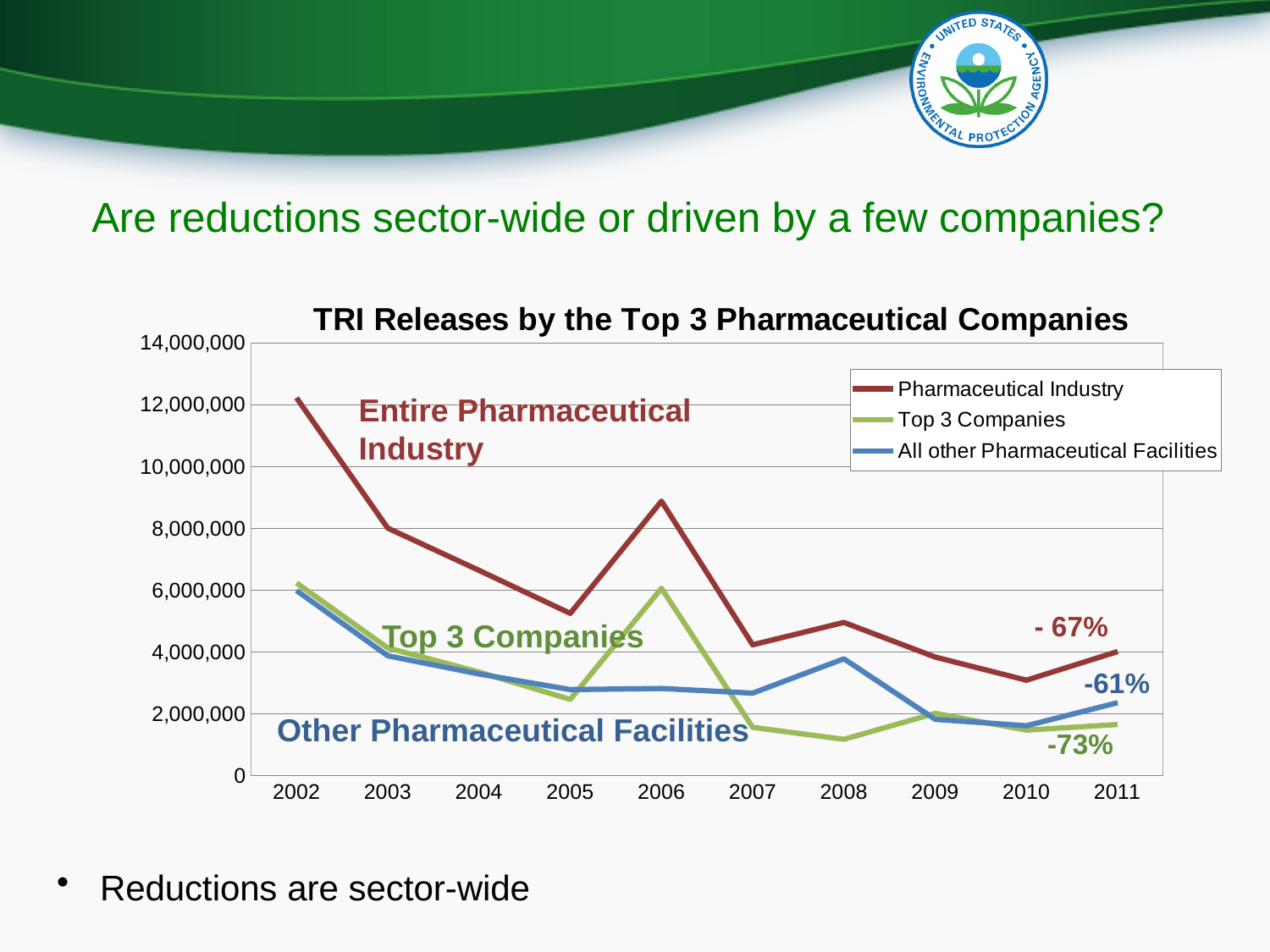
Is the Pharmaceutical Industry value for 2006 greater or less than 8,000,000? greater In 2006, which is larger: the Top 3 Companies value or the All other Pharmaceutical Facilities value? Top 3 Companies Is the Top 3 Companies value for 2008 greater or less than 2,000,000? less What percentage change is labelled for the Pharmaceutical Industry line at the right of the chart? - 67% What type of chart is shown on the slide? Line chart What percentage change is labelled for the All other Pharmaceutical Facilities line at the right of the chart? -61% How many years are plotted along the x axis? 10 What is the title of the chart? TRI Releases by the Top 3 Pharmaceutical Companies In which year is the Pharmaceutical Industry value lowest? 2010 In which year is the Pharmaceutical Industry value highest? 2002 What percentage change is labelled for the Top 3 Companies line at the right of the chart? -73% How many series does the legend list? 3